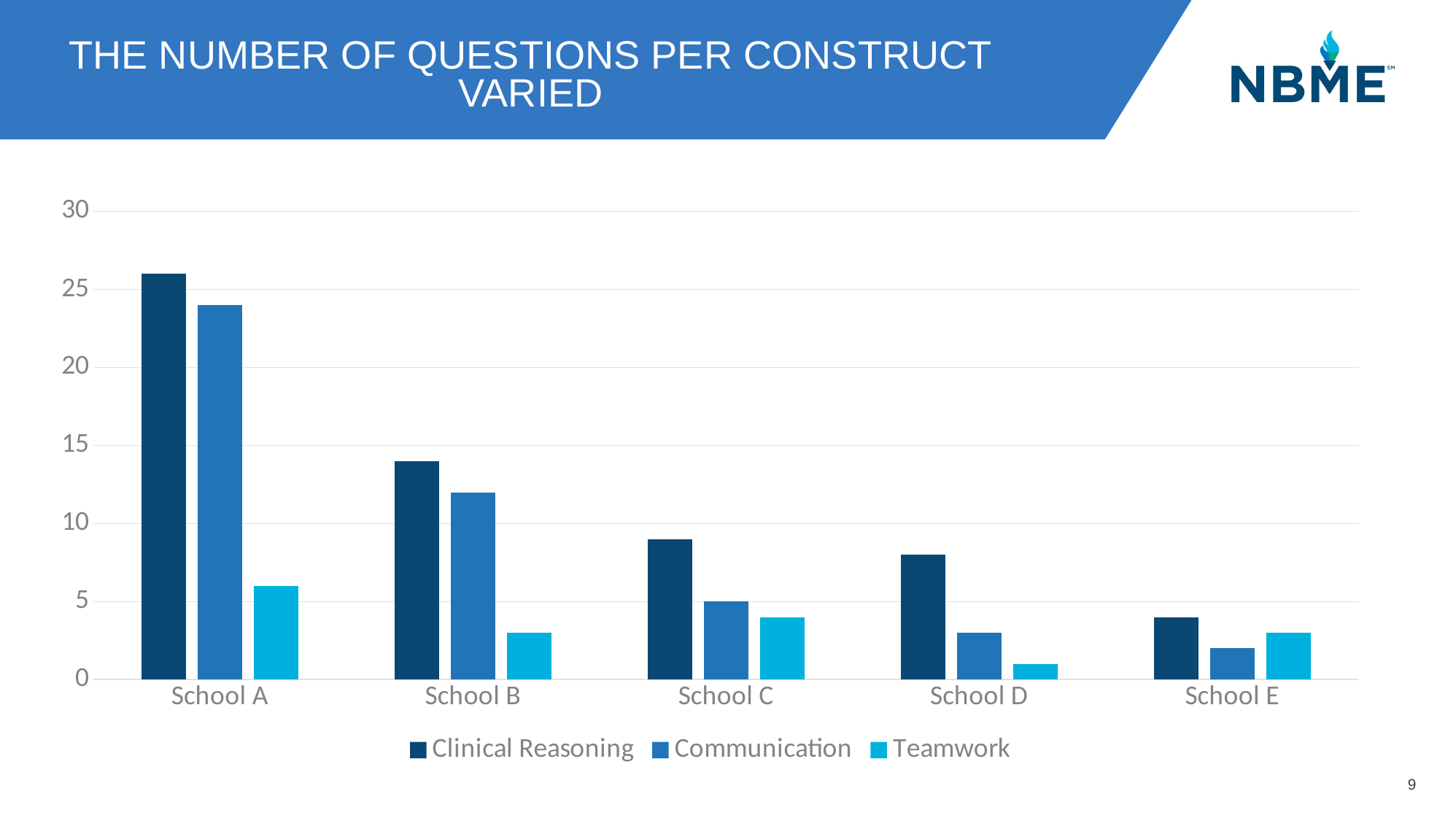
What is the title of the slide? THE NUMBER OF QUESTIONS PER CONSTRUCT VARIED Is the Communication value for School B greater or less than 10? greater For School E, which is larger: Teamwork or Communication? Teamwork Does the Clinical Reasoning value rise or fall from School A to School E? fall How many series does the legend list? 3 Which school has the lowest Communication value? School E How many schools are shown on the x axis? 5 Which school has the highest Clinical Reasoning value? School A Is the Clinical Reasoning value for School A greater or less than 25? greater Which school has the lowest Teamwork value? School D Is the Teamwork value for School A greater or less than 10? less What kind of chart is shown on the slide? bar chart